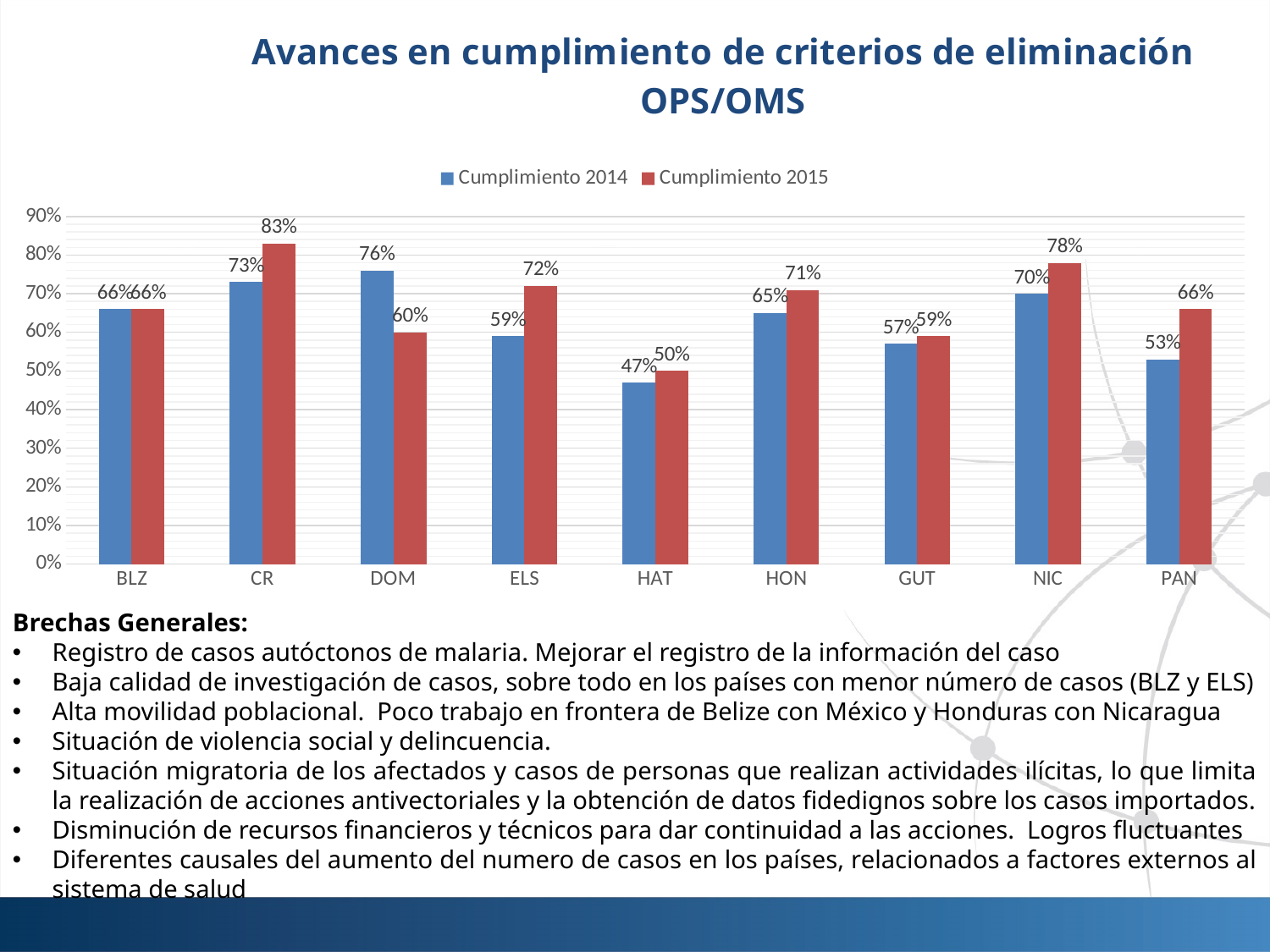
What colour are the Cumplimiento 2015 bars? Red What is the Cumplimiento 2014 value for DOM? 76% What is the Cumplimiento 2015 value for PAN? 66% Is the Cumplimiento 2015 value for HAT greater or less than 60%? less Which country has the highest Cumplimiento 2015 value? CR What is the difference between the Cumplimiento 2015 and Cumplimiento 2014 values for ELS? 13% What is the Cumplimiento 2015 value for CR? 83% How many countries are shown on the x axis of the chart? 9 For DOM, which is larger: Cumplimiento 2014 or Cumplimiento 2015? Cumplimiento 2014 Which country has the lowest Cumplimiento 2014 value? HAT How many series does the legend list? 2 What kind of chart is shown on the slide? Bar chart